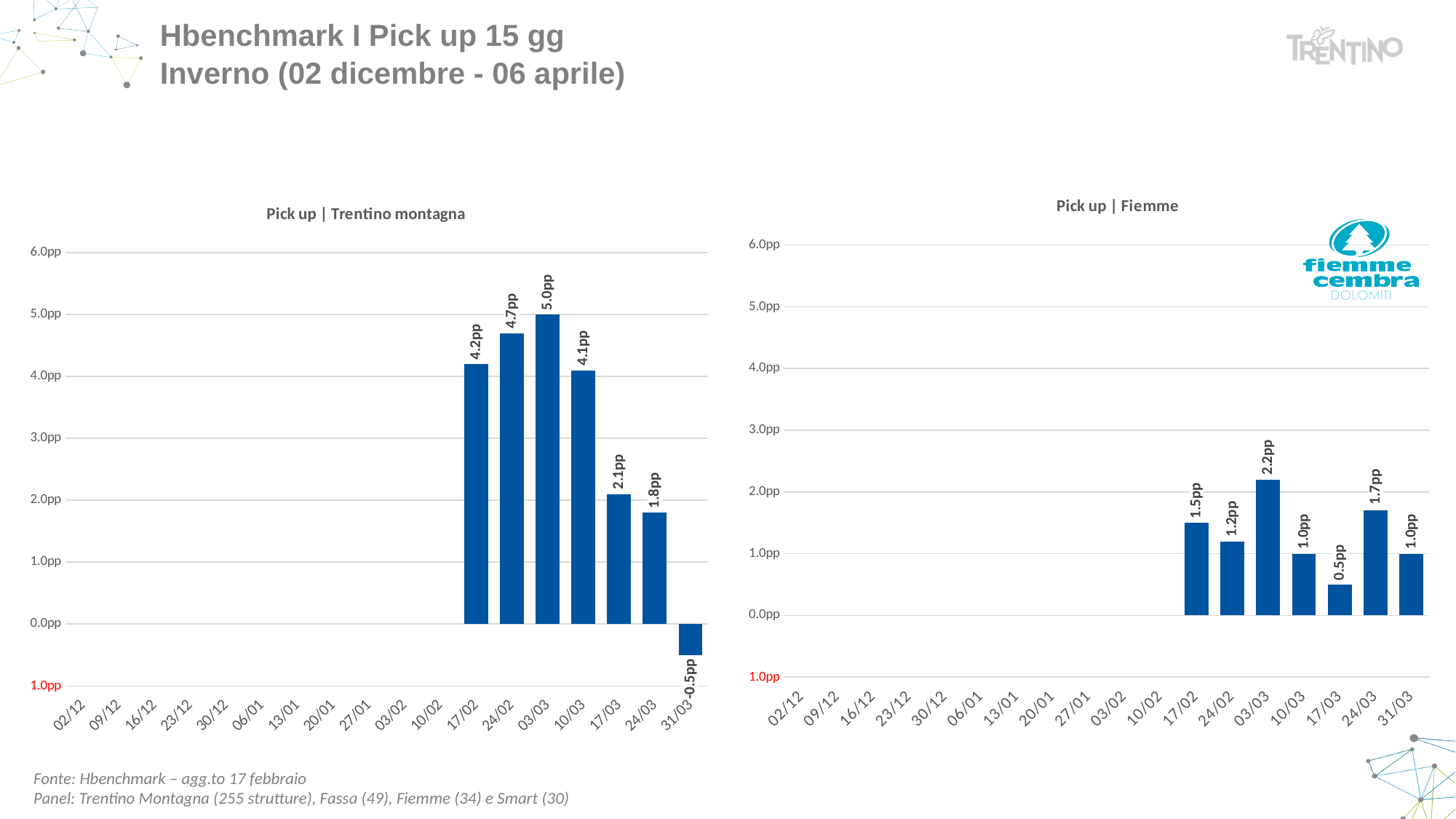
How many bars are plotted in the 'Pick up | Fiemme' chart? 7 In the 'Pick up | Trentino montagna' chart, is the value for 10/03 greater or less than 3.0pp? greater In the 'Pick up | Fiemme' chart, what is the difference between the values for 03/03 and 24/02? 1.0pp In the 'Pick up | Trentino montagna' chart, what is the value for 03/03? 5.0pp In the 'Pick up | Fiemme' chart, what is the value for 17/03? 0.5pp In the 'Pick up | Trentino montagna' chart, which date has the lowest value? 31/03 In the 'Pick up | Fiemme' chart, which date has the highest value? 03/03 In the 'Pick up | Trentino montagna' chart, what is the difference between the values for 24/02 and 17/03? 2.6pp In the 'Pick up | Fiemme' chart, which is larger, the value for 17/02 or the value for 24/03? 24/03 In the 'Pick up | Trentino montagna' chart, do the values rise or fall from 03/03 to 31/03? fall In the 'Pick up | Trentino montagna' chart, what is the value for 31/03? -0.5pp What kind of chart is 'Pick up | Trentino montagna'? bar chart